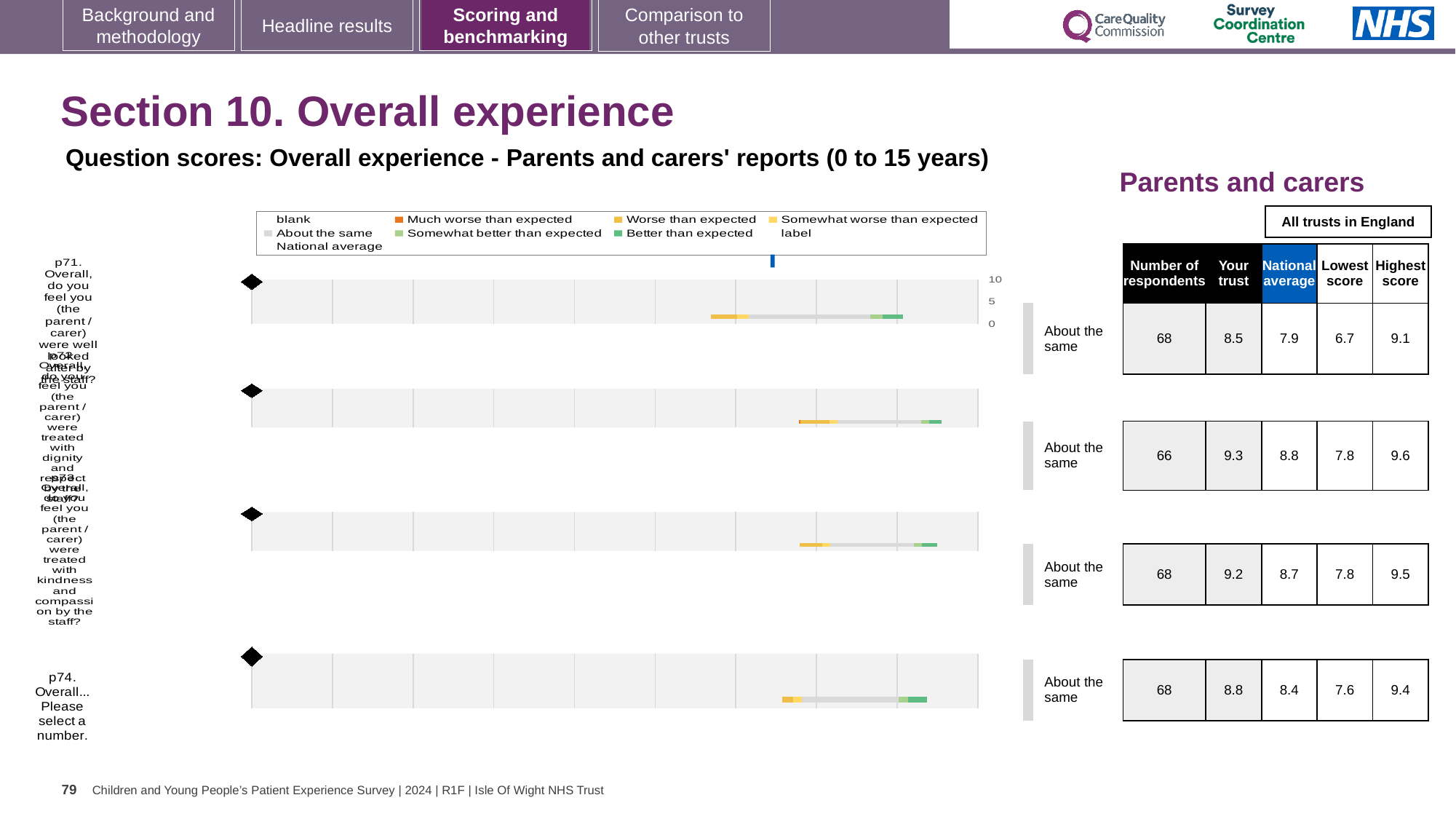
According to the table beside the chart, what is the national average for p74 (Overall... Please select a number)? 8.4 For p74, which is larger: the 'Your trust' score or the national average? Your trust (8.8) According to the table beside the chart, what is the 'Your trust' score for p71 (Overall, do you feel you were well looked after by the staff)? 8.5 What is the number of respondents for p74 in the table beside the chart? 68 What is the title of the table to the right of the chart? Parents and carers What kind of chart is shown on the slide? bar chart Which question row has the lowest 'Your trust' score in the table beside the chart? p71 (8.5) How many question rows (bars) are plotted in the chart? 4 Which question row has the highest 'Your trust' score in the table beside the chart? the second row (9.3) What benchmark category is shown next to each bar in the chart? About the same What is the difference between the 'Your trust' score and the national average for p71? 0.6 What is the highest score across all trusts in England for p71 in the table beside the chart? 9.1